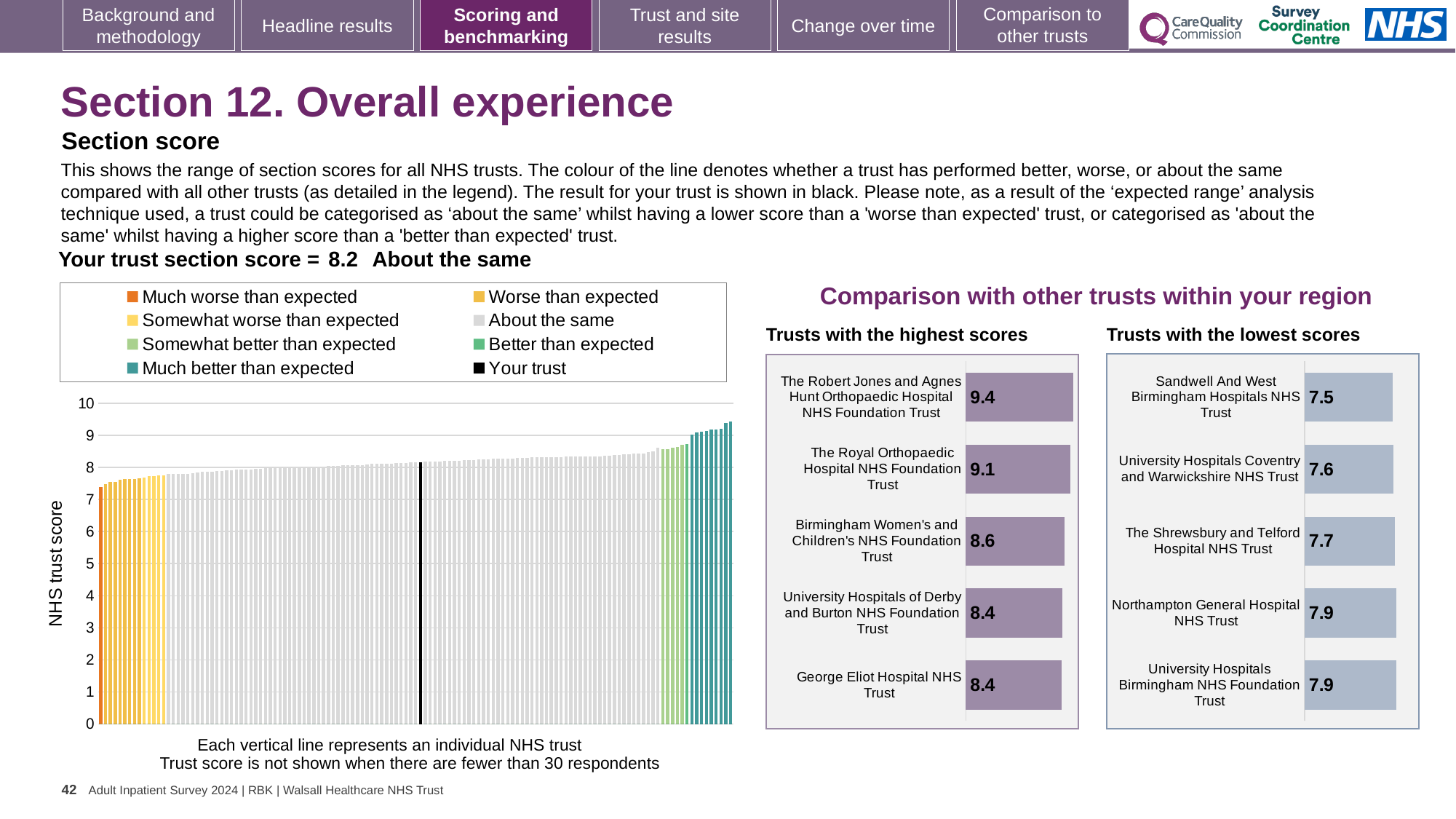
In the 'Trusts with the lowest scores' chart, what is the difference between the scores of Northampton General Hospital NHS Trust and Sandwell And West Birmingham Hospitals NHS Trust? 0.4 How many trusts are shown in the 'Trusts with the lowest scores' chart? 5 In the 'Trusts with the highest scores' chart, what is the score for The Robert Jones and Agnes Hunt Orthopaedic Hospital NHS Foundation Trust? 9.4 How many entries does the legend of the main chart on the left list? 8 In the 'Trusts with the highest scores' chart, which trust has the highest score? The Robert Jones and Agnes Hunt Orthopaedic Hospital NHS Foundation Trust In the 'Trusts with the lowest scores' chart, what is the score for Sandwell And West Birmingham Hospitals NHS Trust? 7.5 In the 'Trusts with the highest scores' chart, what is the score for Birmingham Women's and Children's NHS Foundation Trust? 8.6 In the main chart on the left showing all NHS trusts, what is the section score for your trust? 8.2 In the main chart on the left showing all NHS trusts, do the scores rise or fall from left to right? rise In the 'Trusts with the lowest scores' chart, which trust has the lowest score? Sandwell And West Birmingham Hospitals NHS Trust In the 'Trusts with the highest scores' chart, which has the higher score: The Royal Orthopaedic Hospital NHS Foundation Trust or University Hospitals of Derby and Burton NHS Foundation Trust? The Royal Orthopaedic Hospital NHS Foundation Trust In the 'Trusts with the highest scores' chart, what is the difference between the scores of The Robert Jones and Agnes Hunt Orthopaedic Hospital NHS Foundation Trust and Birmingham Women's and Children's NHS Foundation Trust? 0.8